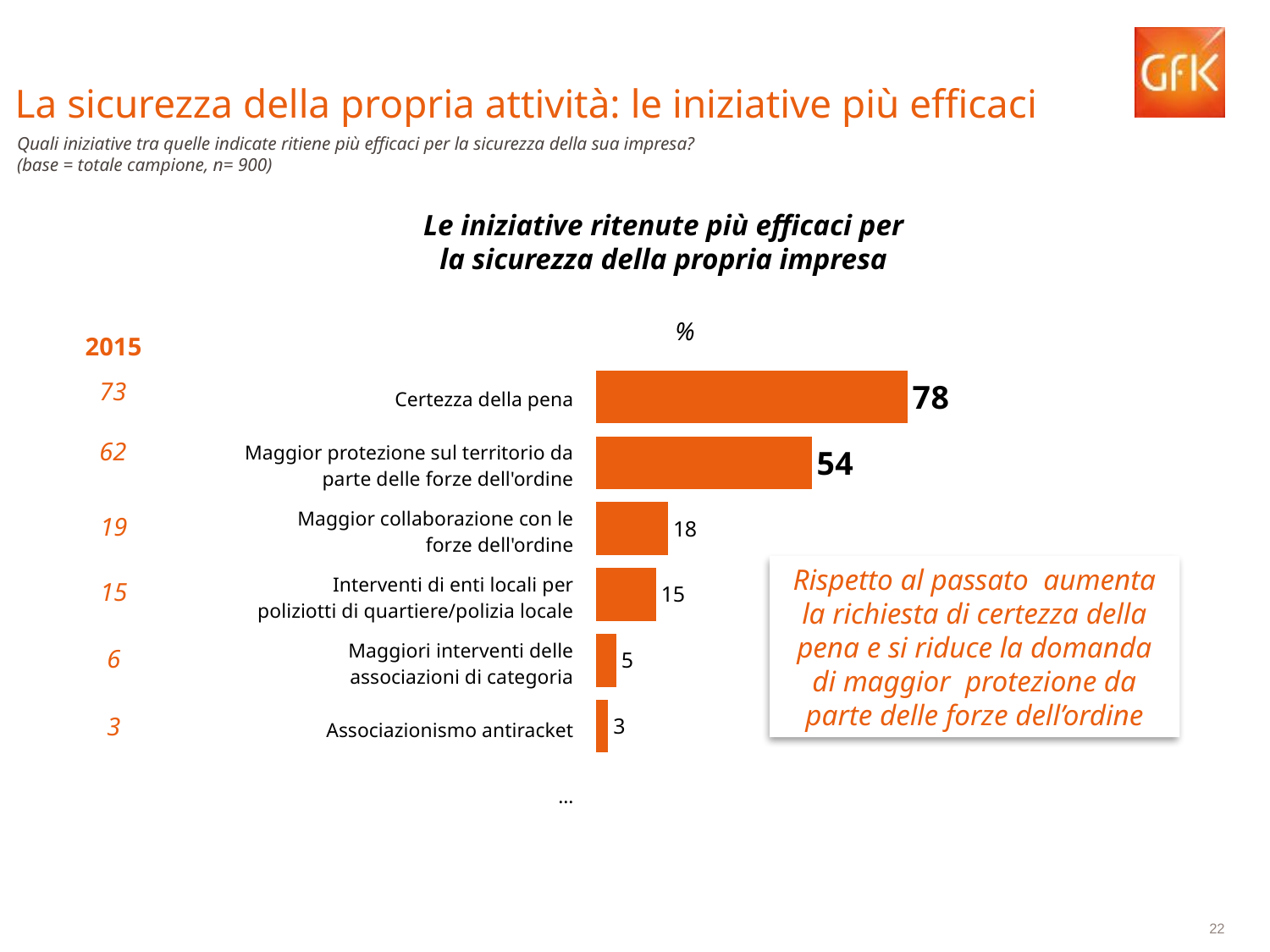
What is the title of the chart? Le iniziative ritenute più efficaci per la sicurezza della propria impresa What colour are the bars in the chart? Orange Which category has the lowest value? Associazionismo antiracket What kind of chart is shown on the slide? Bar chart Which category has the highest value? Certezza della pena What is the value for "Maggior protezione sul territorio da parte delle forze dell'ordine"? 54 What is the value for "Maggior collaborazione con le forze dell'ordine"? 18 How many categories are shown in the chart? 6 What is the value for "Associazionismo antiracket"? 3 Which is larger: the value for "Interventi di enti locali per poliziotti di quartiere/polizia locale" or the value for "Maggiori interventi delle associazioni di categoria"? Interventi di enti locali per poliziotti di quartiere/polizia locale What is the difference between the values for "Certezza della pena" and "Maggior protezione sul territorio da parte delle forze dell'ordine"? 24 What is the value for "Certezza della pena"? 78